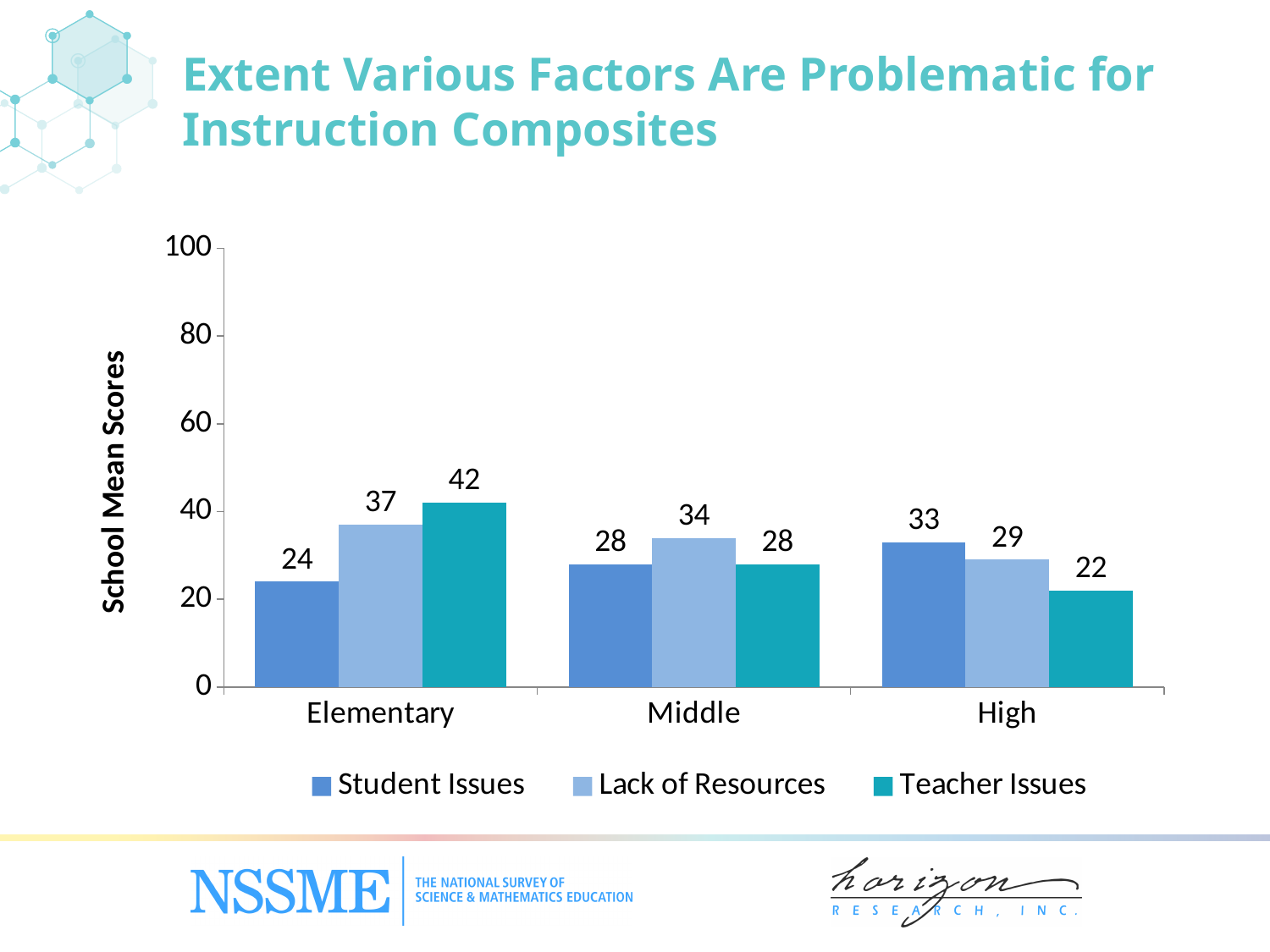
Which grade level has the highest Teacher Issues value? Elementary What is the Student Issues value for High? 33 Is the Lack of Resources value for Elementary greater or less than 40? less What is the label of the y axis? School Mean Scores What is the Teacher Issues value for Elementary? 42 What is the Lack of Resources value for Middle? 34 What is the difference between the Teacher Issues values for Elementary and High? 20 How many series does the legend list? 3 How many grade-level categories are shown on the x axis? 3 What kind of chart is shown on the slide? Bar chart Which grade level has the lowest Student Issues value? Elementary Which is larger for High: Student Issues or Teacher Issues? Student Issues